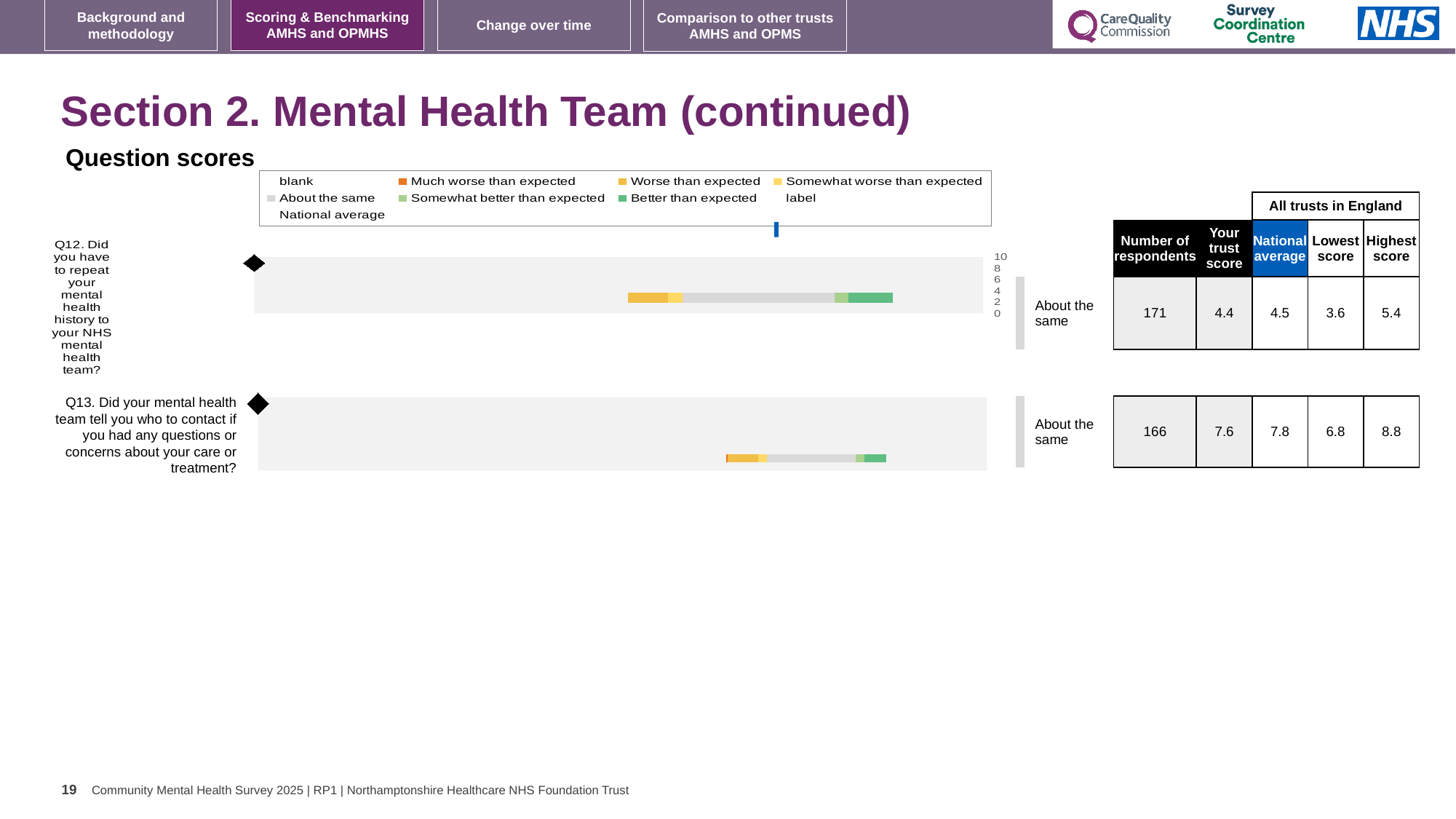
How many respondents answered Q13? 166 Which legend entry is shown in dark green? Better than expected What is the difference between the highest and lowest trust scores for Q13? 2.0 Is the trust's score for Q12 greater or less than 4 on the axis? greater Which legend entry is shown in orange? Much worse than expected What is the trust's score for Q12 (repeating mental health history)? 4.4 What is the highest score among all trusts in England for Q12? 5.4 How many survey questions are plotted on the slide? 2 What kind of chart is used to show the question scores for Q12 and Q13? bar chart What is the national average score for Q13 (told who to contact with questions or concerns)? 7.8 How is the trust's result for Q12 categorised relative to expectations? About the same For Q13, which is larger: the trust's score or the national average? national average